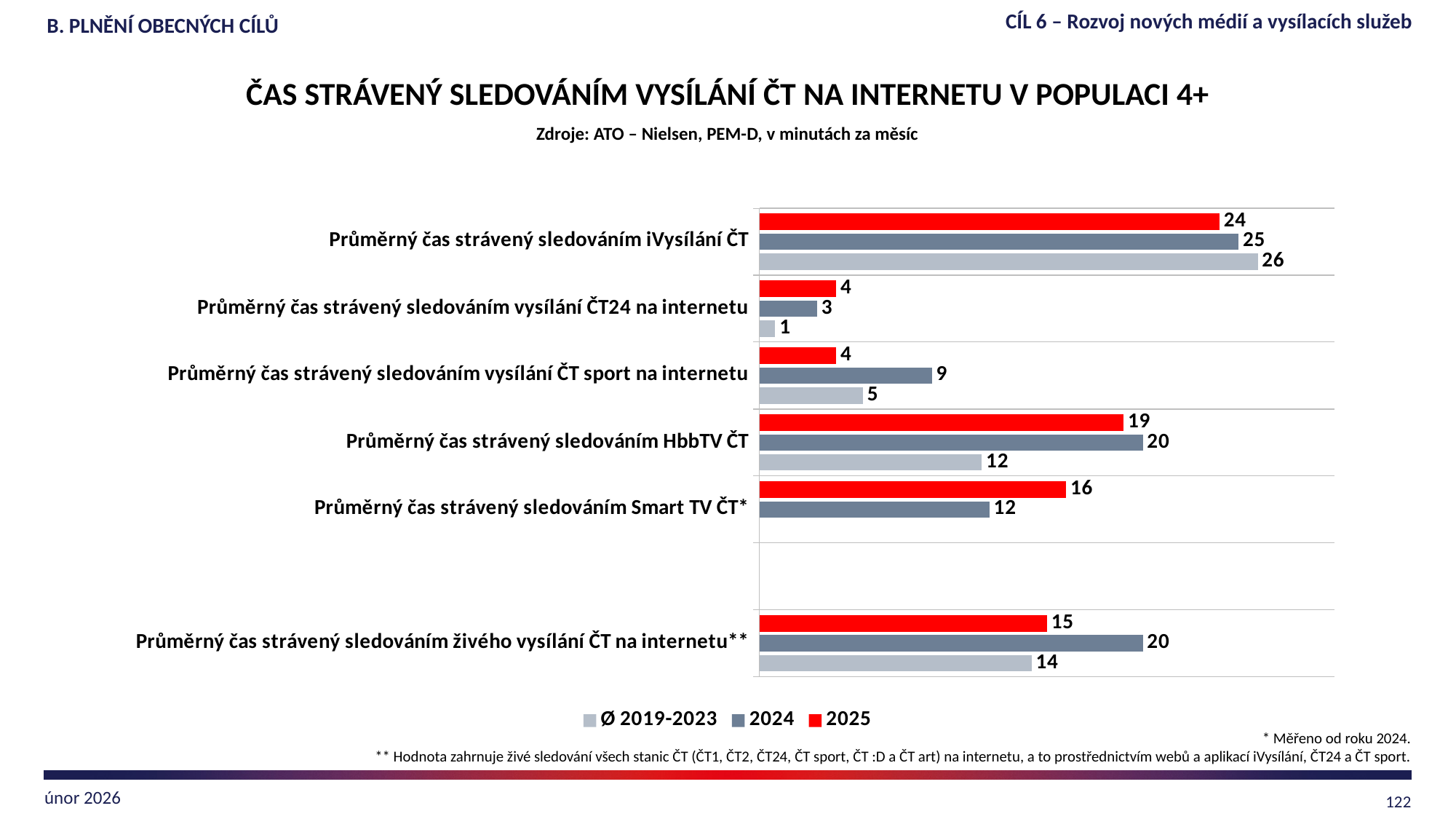
How many series does the legend list? 3 Which category has the lowest Ø 2019-2023 value? Průměrný čas strávený sledováním vysílání ČT24 na internetu What kind of chart is shown on the slide? Bar chart What is the Ø 2019-2023 value for Průměrný čas strávený sledováním HbbTV ČT? 12 Which series is shown in red in the legend? 2025 What is the 2024 value for Průměrný čas strávený sledováním vysílání ČT sport na internetu? 9 What is the 2025 value for Průměrný čas strávený sledováním iVysílání ČT? 24 Which category has the highest 2025 value? Průměrný čas strávený sledováním iVysílání ČT What is the difference between the Ø 2019-2023 and 2025 values for Průměrný čas strávený sledováním HbbTV ČT? 7 What is the difference between the 2024 and 2025 values for Průměrný čas strávený sledováním Smart TV ČT*? 4 Which is larger for Průměrný čas strávený sledováním vysílání ČT sport na internetu: the 2024 value or the 2025 value? 2024 What is the 2024 value for Průměrný čas strávený sledováním živého vysílání ČT na internetu**? 20